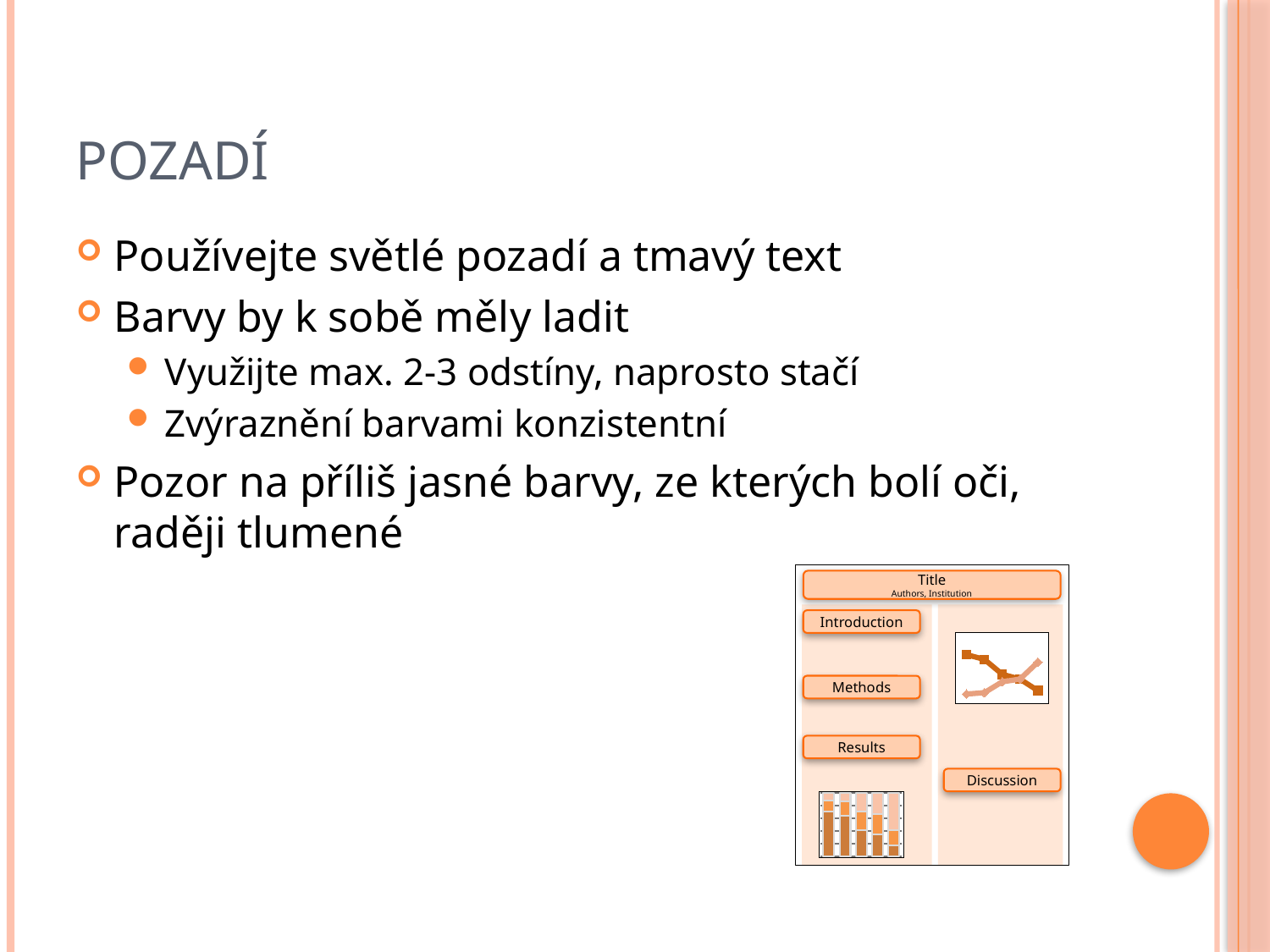
What kind of chart is shown in the upper right of the poster mockup on the slide? line chart Do the two lines in the line chart in the poster mockup cross each other? yes How many lines are plotted in the line chart in the poster mockup? 2 Are the bars in the bar chart in the poster mockup stacked or side by side? stacked How many bars are shown in the bar chart in the poster mockup? 5 What kind of chart is shown in the lower left of the poster mockup on the slide? bar chart In the line chart in the poster mockup, does the darker line rise or fall from left to right? fall In the line chart in the poster mockup, does the lighter line rise or fall from left to right? rise